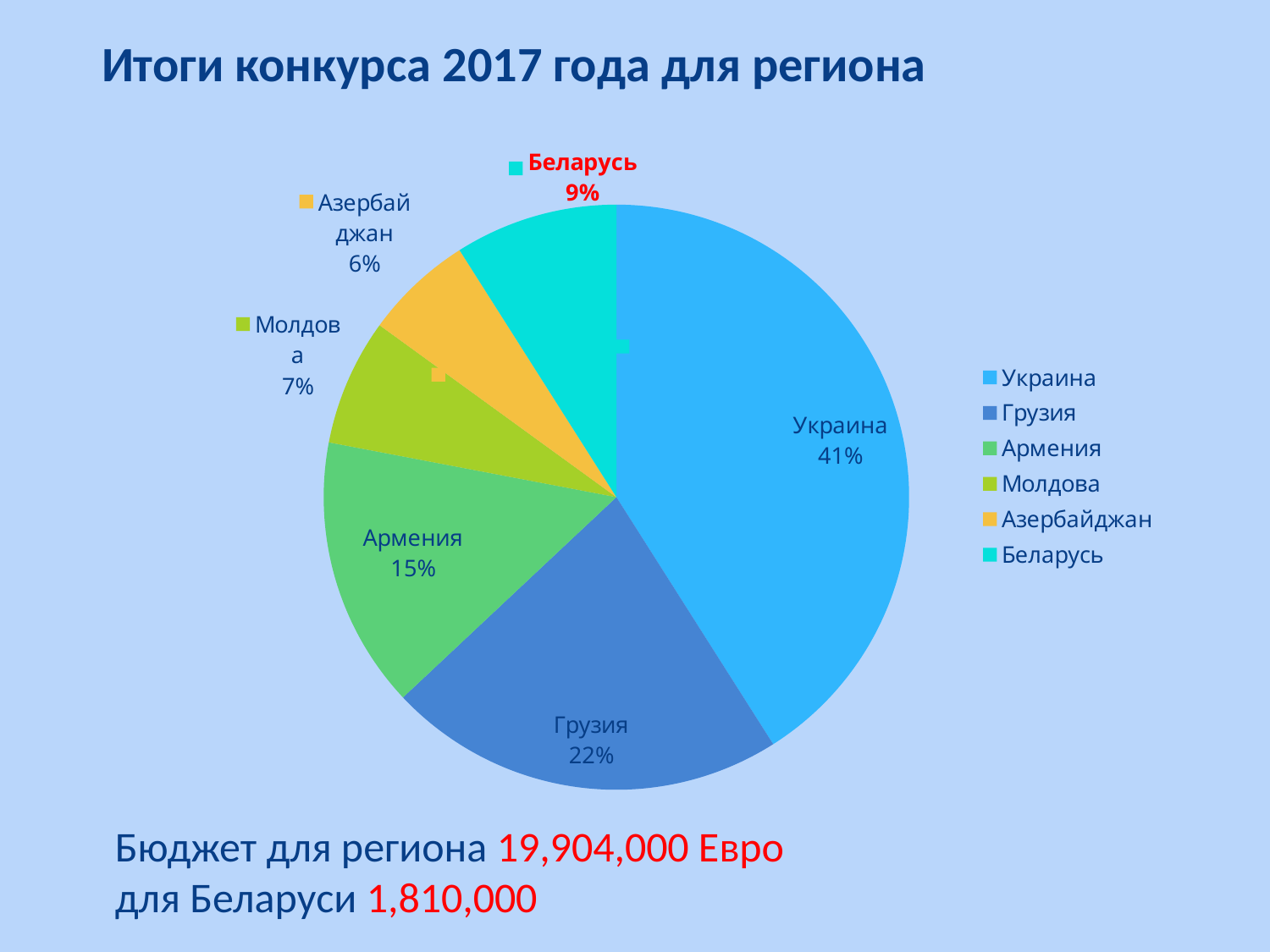
What is the title of the slide? Итоги конкурса 2017 года для региона Which category has the smallest slice of the pie? Азербайджан What share of the pie does Армения have? 15% What kind of chart is shown on the slide? pie chart How many categories does the pie chart show? 6 Which is larger, the share for Молдова or the share for Беларусь? Беларусь What share of the pie does Беларусь have? 9% What share of the pie does Грузия have? 22% Which category has the largest slice of the pie? Украина What is the difference in percentage points between Украина and Грузия? 19